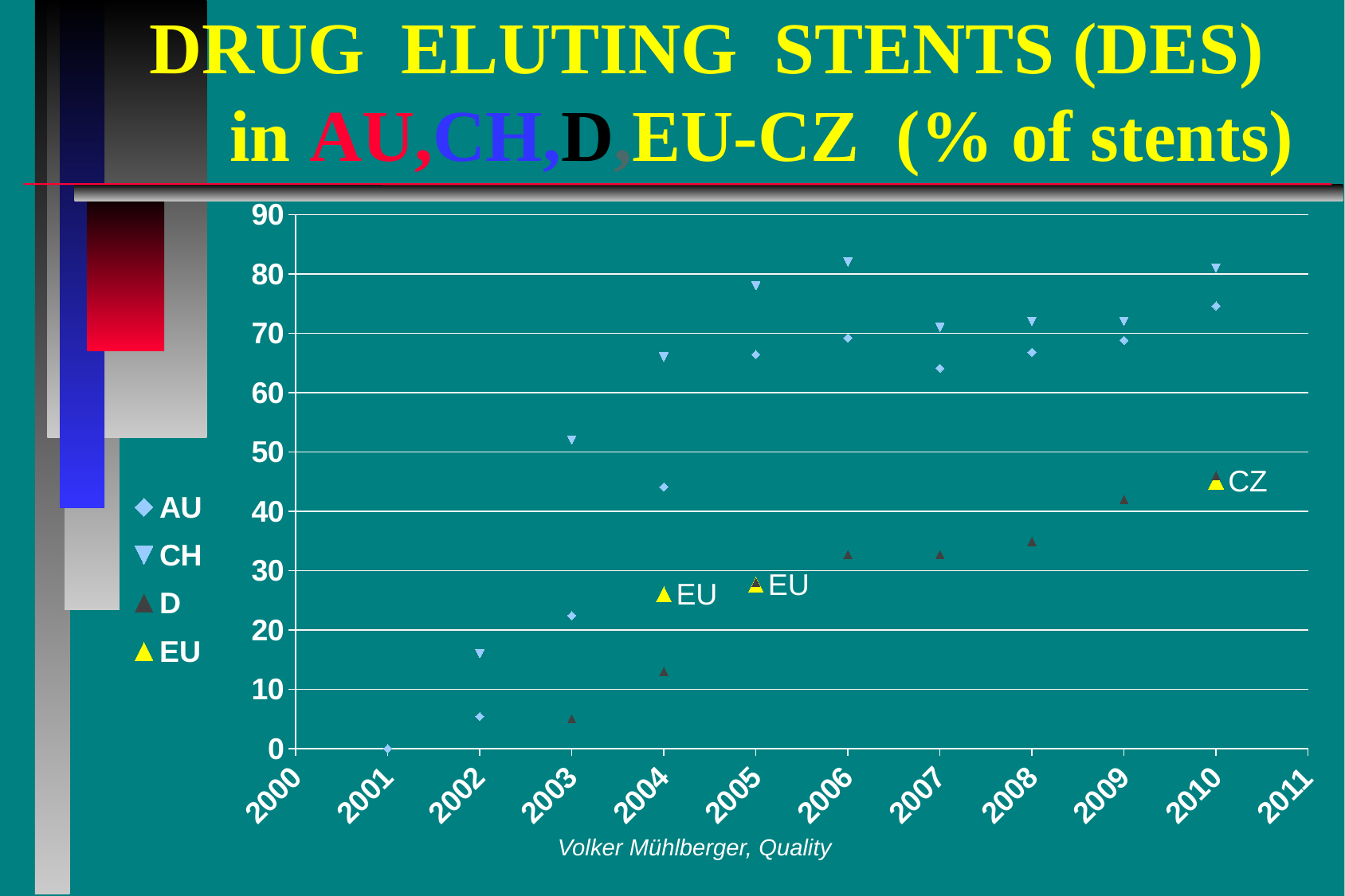
In which year does the AU series reach its highest value? 2010 What kind of chart is shown on the slide? scatter chart Is the CH value for 2003 greater or less than 50? greater How many series does the legend list? 4 Is the D value for 2004 greater or less than 20? less Is the AU value for 2004 greater or less than 40? greater Which series are listed in the legend? AU, CH, D, EU Do the D series values generally rise or fall from 2003 to 2010? rise In 2005, which series has the higher value, CH or AU? CH In 2008, which series has the lower value, D or AU? D